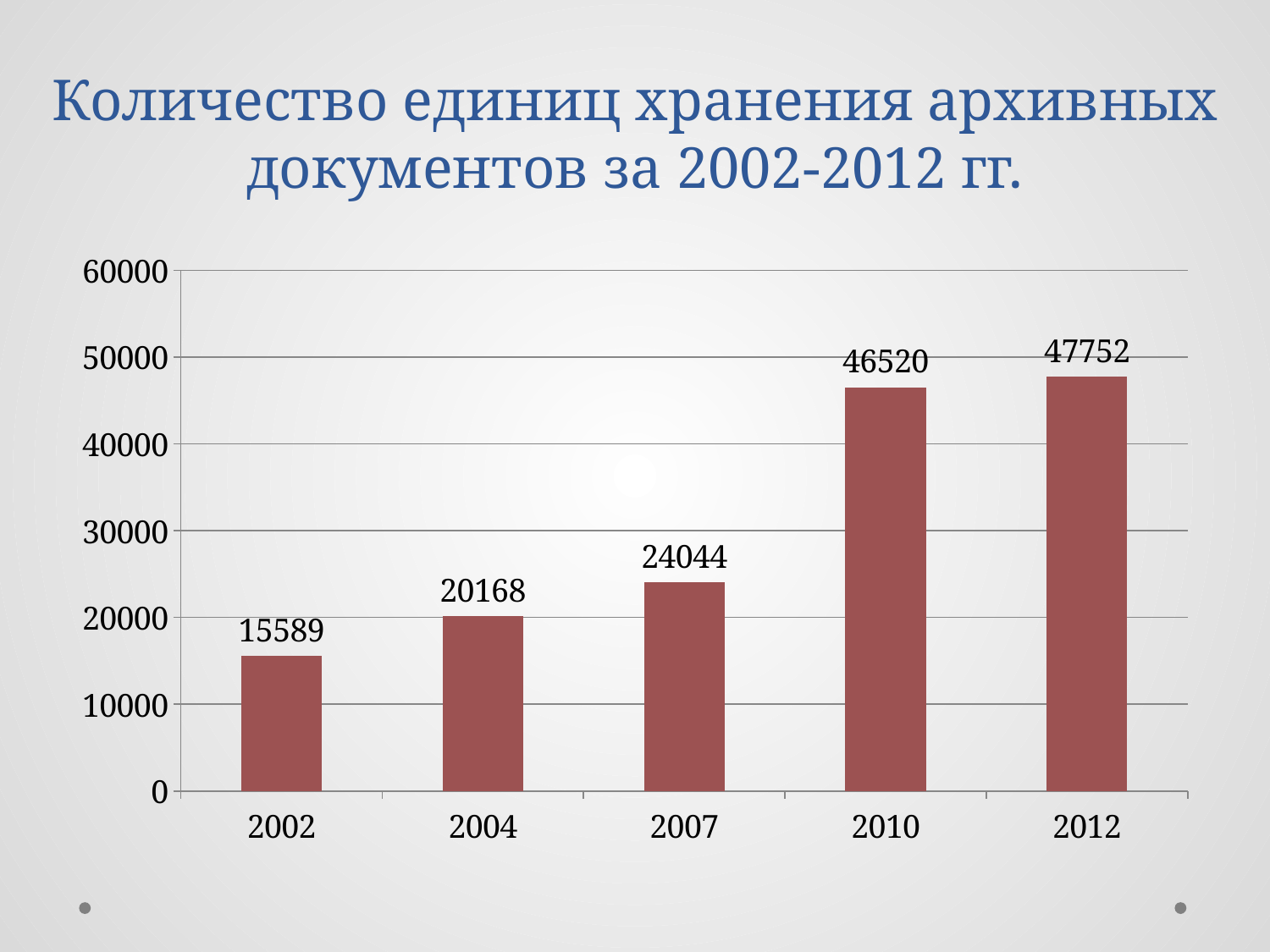
What is the value for 2010? 46520 Which year has the highest value? 2012 How many years are shown on the x axis? 5 What is the value for 2002? 15589 What is the difference between the values for 2007 and 2004? 3876 Which is larger, the value for 2004 or the value for 2007? 2007 Is the value for 2010 greater or less than 40000? greater Do the values rise or fall from 2002 to 2012? rise Which year has the lowest value? 2002 What kind of chart is shown on the slide? bar chart What is the difference between the values for 2012 and 2010? 1232 What is the value for 2007? 24044